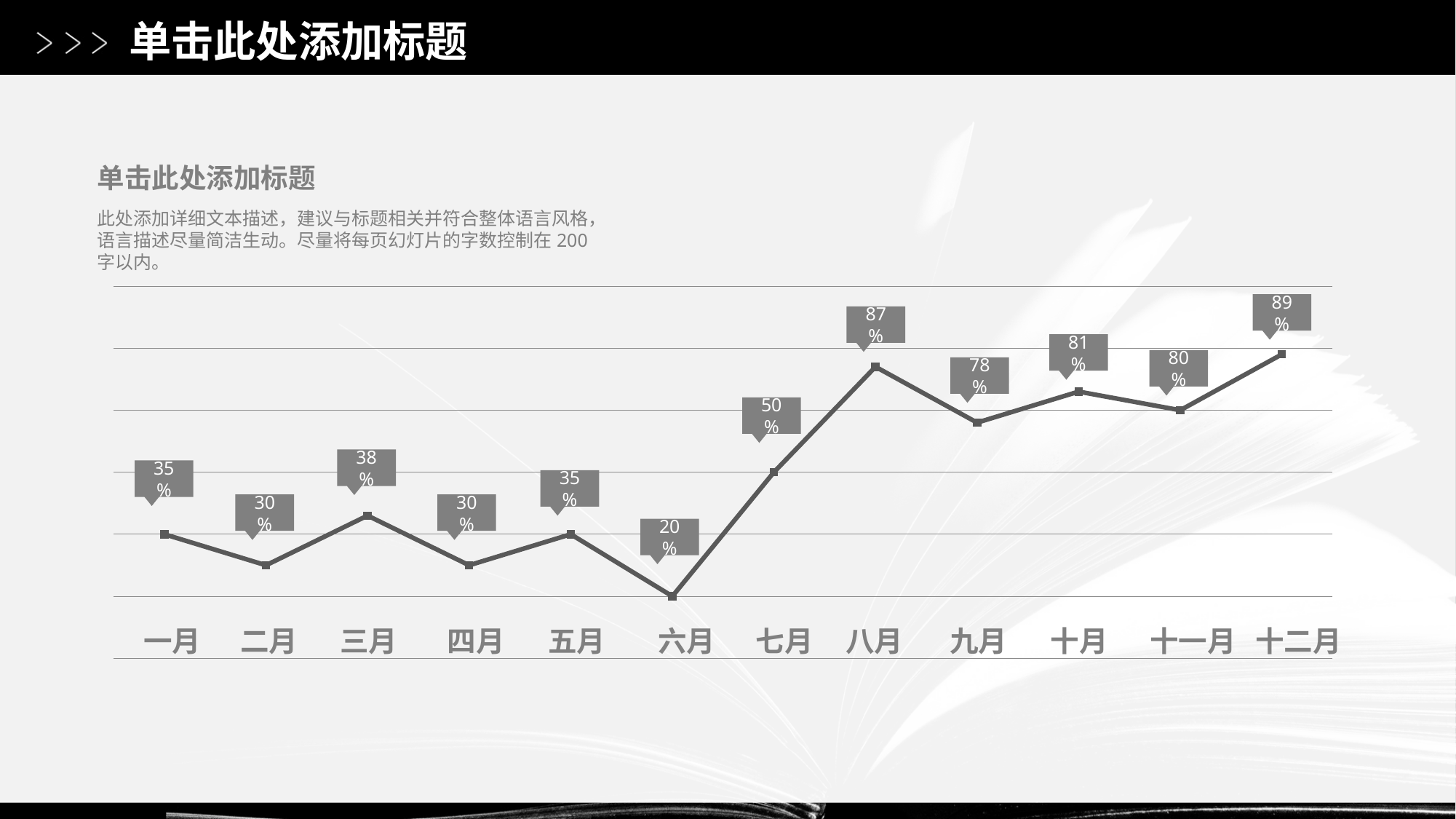
What is the difference between the values for 八月 and 七月? 37% What kind of chart is shown on the slide? line chart What is the value for 八月 (August)? 87% What is the difference between the values for 十二月 and 一月? 54% Which is larger, the value for 一月 or the value for 二月? 一月 Which month has the lowest value? 六月 Which is larger, the value for 九月 or the value for 十月? 十月 Which month has the highest value? 十二月 What is the value for 六月 (June)? 20% Does the value rise or fall from 七月 to 八月? rise What is the value for 三月 (March)? 38% How many months are plotted on the x axis? 12